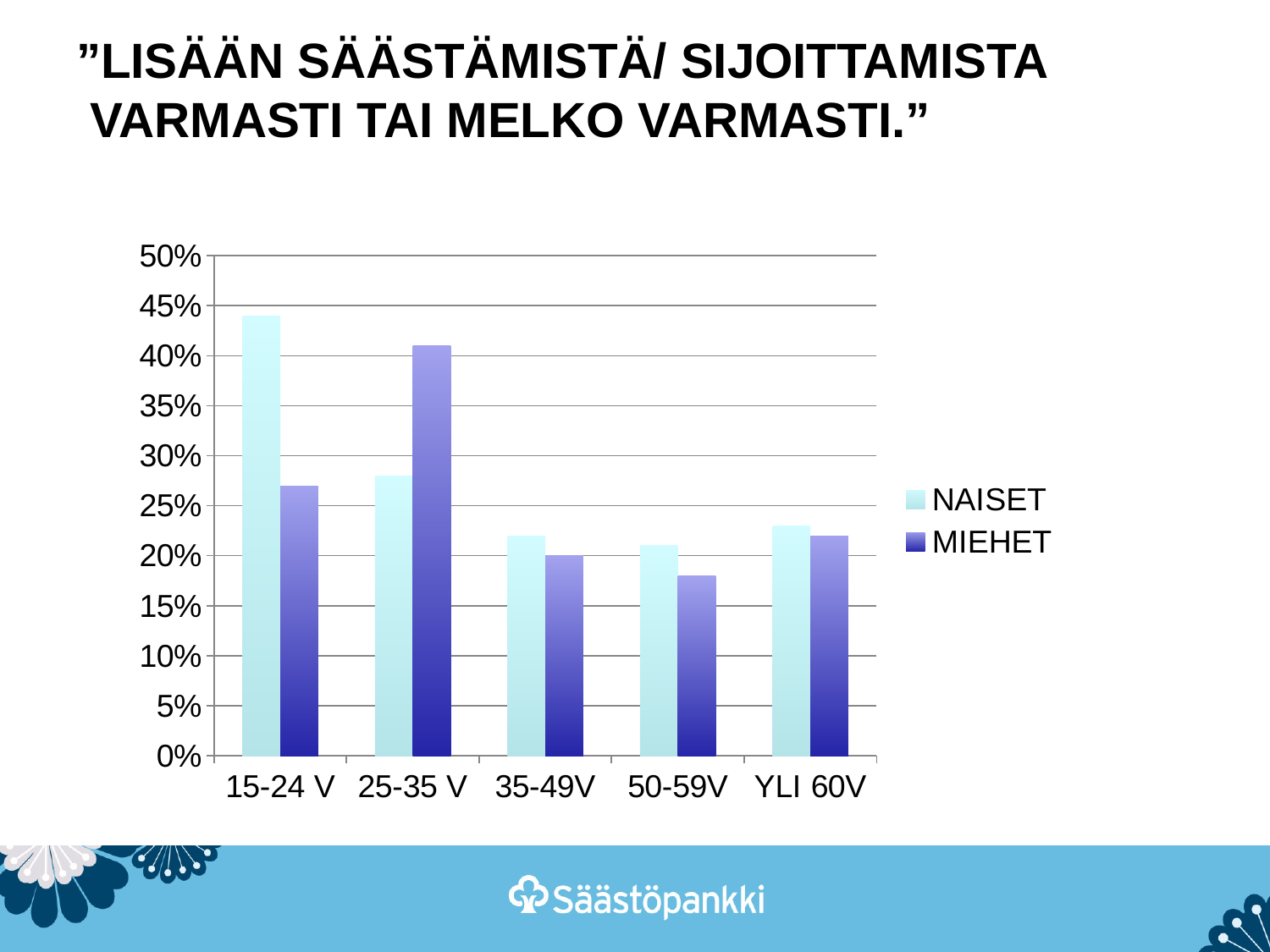
In the 15-24 V age group, which is larger, NAISET or MIEHET? NAISET Which age group has the lowest value for MIEHET? 50-59V What kind of chart is shown on the slide? bar chart Is the value for MIEHET in the 25-35 V age group greater or less than 35%? greater Is the value for NAISET in the 15-24 V age group greater or less than 40%? greater Which age group has the highest value for MIEHET? 25-35 V In the 25-35 V age group, which is larger, NAISET or MIEHET? MIEHET Which age group has the highest value for NAISET? 15-24 V What are the two series named in the chart's legend? NAISET and MIEHET How many series does the chart's legend list? 2 How many age groups are shown on the x axis of the chart? 5 Is the value for MIEHET in the 50-59V age group greater or less than 20%? less